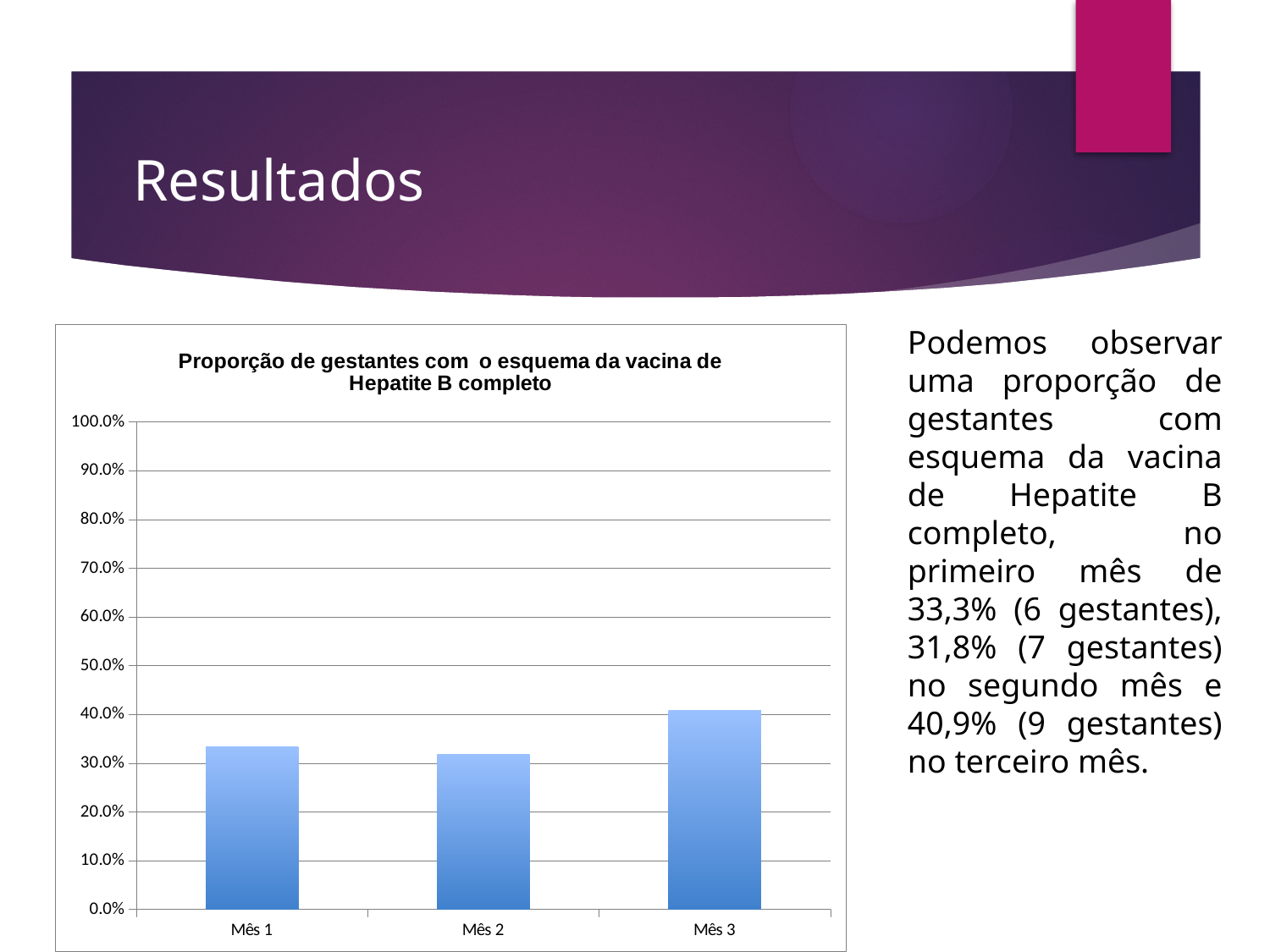
Is the value for Mês 3 greater or less than 40.0%? greater Does the value rise or fall from Mês 2 to Mês 3? rise Which month has the highest proportion in the chart? Mês 3 Is the value for Mês 2 greater or less than 30.0%? greater What kind of chart is shown on the slide? bar chart Is the value for Mês 1 greater or less than 40.0%? less What is the title of the chart? Proporção de gestantes com o esquema da vacina de Hepatite B completo Which month has the lowest proportion in the chart? Mês 2 Which is larger, the value for Mês 3 or the value for Mês 2? Mês 3 What is the maximum value shown on the vertical axis of the chart? 100.0% How many categories (months) are plotted in the chart? 3